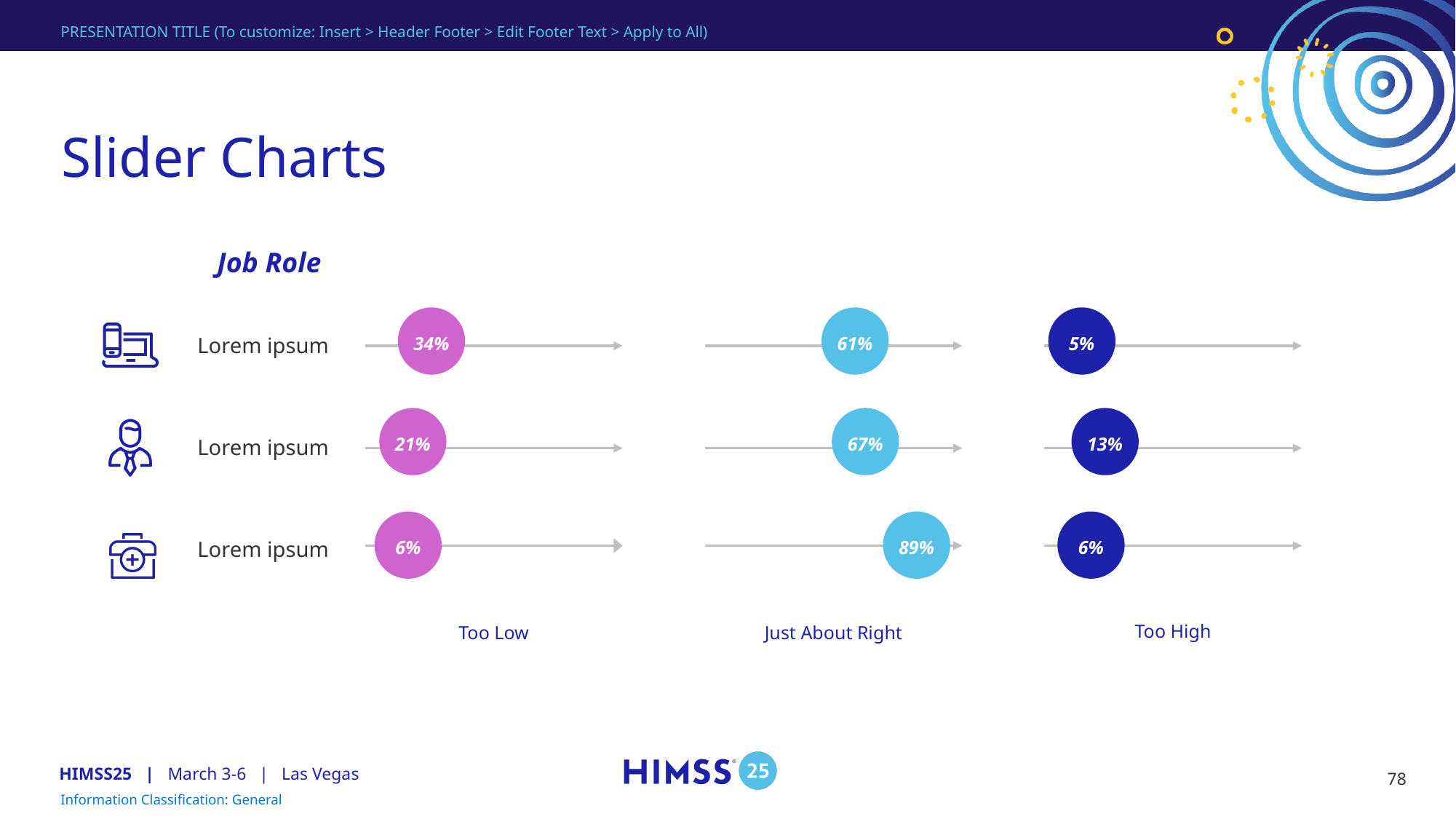
Which row has the highest 'Just About Right' value? The bottom row (89%) Which row has the lowest 'Too Low' value? The bottom row (6%) Which is larger: the 'Too Low' value of the top row or the 'Too Low' value of the middle row? The top row (34%) What is the heading shown above the row labels of the slider chart? Job Role What is the 'Too High' value for the bottom row of the slider chart? 6% What is the 'Too Low' value for the top row of the slider chart? 34% What is the difference between the 'Just About Right' values of the bottom row and the top row? 28% How many rows of sliders are shown in the chart? 3 What are the three category labels shown beneath the slider columns? Too Low, Just About Right, Too High What is the 'Too High' value for the middle row of the slider chart? 13% How many slider columns (response categories) are shown in the chart? 3 What is the 'Just About Right' value for the middle row of the slider chart? 67%